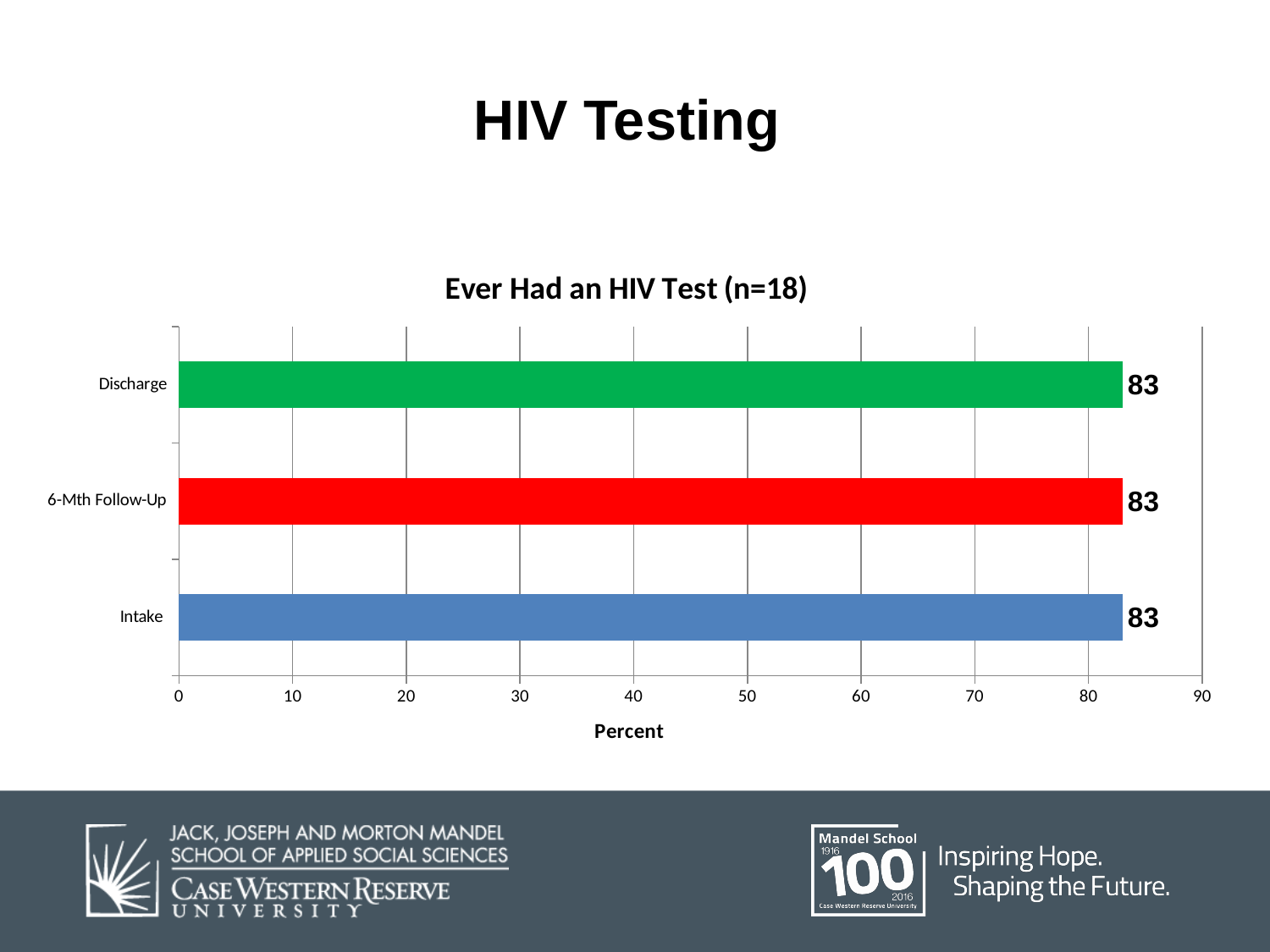
What is the title of the chart? Ever Had an HIV Test (n=18) What is the value for Discharge in the chart? 83 Is the value for Intake greater or less than 80? greater How many categories are shown in the chart? 3 What is the value for Intake in the chart? 83 What is the value for 6-Mth Follow-Up in the chart? 83 What kind of chart is shown on the slide? Bar chart What is the difference between the values for Discharge and Intake? 0 What is the label on the horizontal axis of the chart? Percent Is the value for 6-Mth Follow-Up greater or less than 90? less